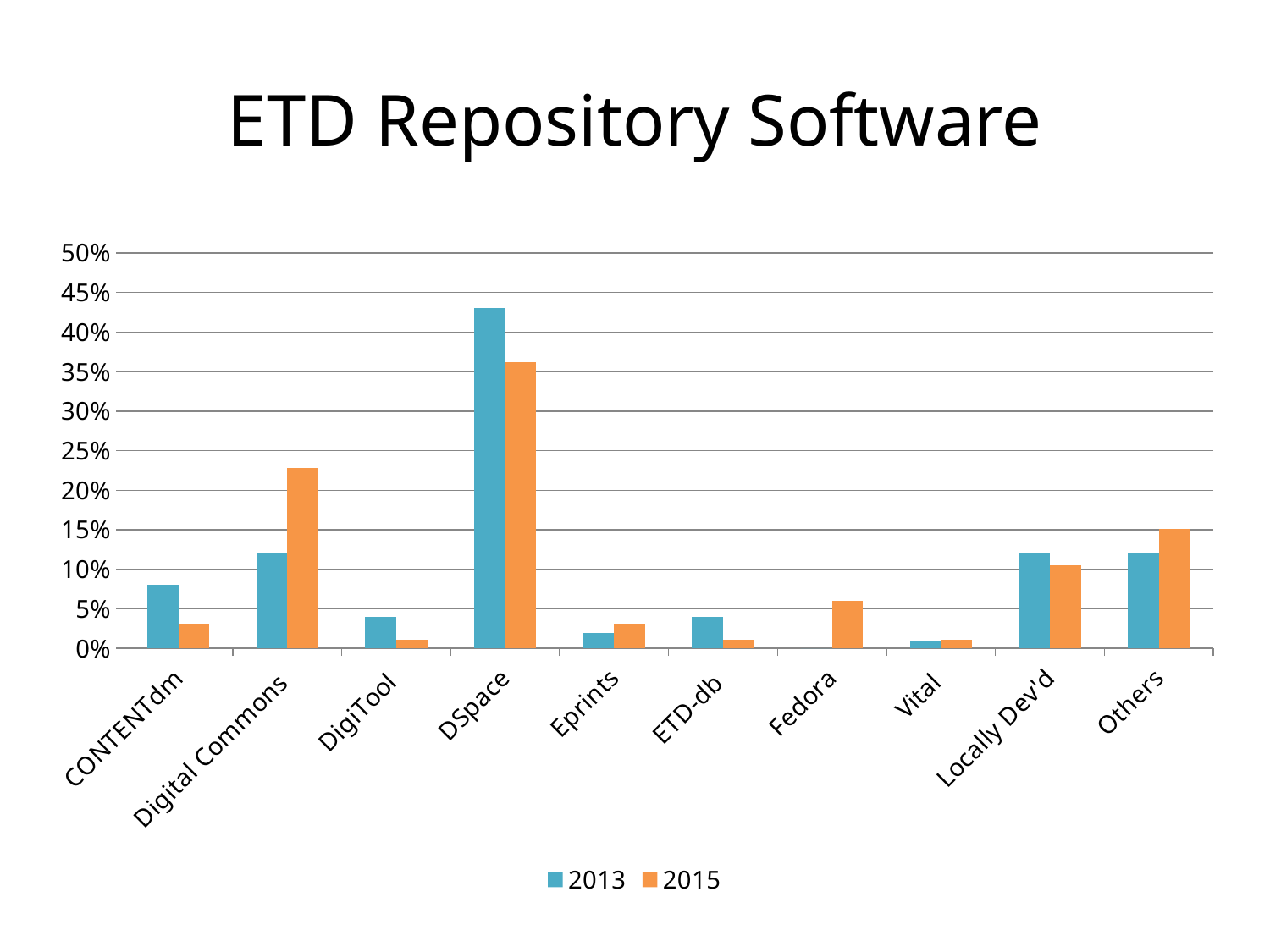
What kind of chart is shown on the slide? bar chart For Digital Commons, which year has the larger value, 2013 or 2015? 2015 How many series does the legend list? 2 For CONTENTdm, which year has the larger value, 2013 or 2015? 2013 Is the 2015 value for DSpace greater or less than 40%? less Which category has the highest value for 2013? DSpace Which category has the highest value for 2015? DSpace What is the title of the chart? ETD Repository Software How many software categories are shown on the x axis? 10 Is the 2015 value for Digital Commons greater or less than 20%? greater Is the 2013 value for DSpace greater or less than 40%? greater Which category has the lowest value for 2013? Fedora